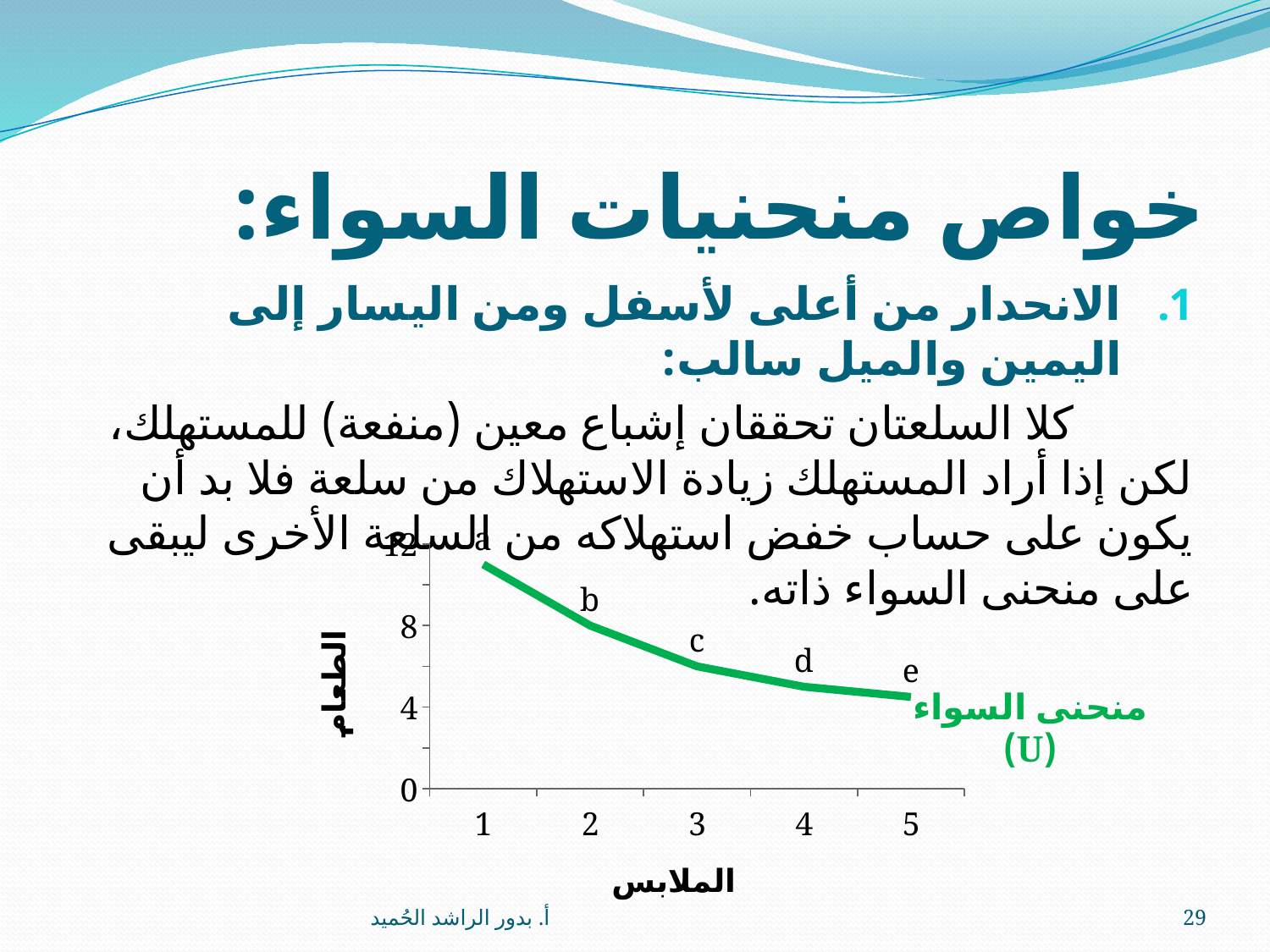
How many series does the chart show? 1 Which labelled point has the lowest value of الطعام? e What kind of chart is shown on the slide? line chart Which labelled point has the highest value of الطعام? a How many labelled points are plotted on the indifference curve? 5 Is the value of الطعام at point c greater or less than 4? greater What is the title of the x axis of the chart? الملابس Which point has a larger value of الطعام, a or e? a Is the value of الطعام at point d greater or less than 8? less What is the value of الطعام at point b? 8 Do the values rise or fall as الملابس increases along the x axis? fall